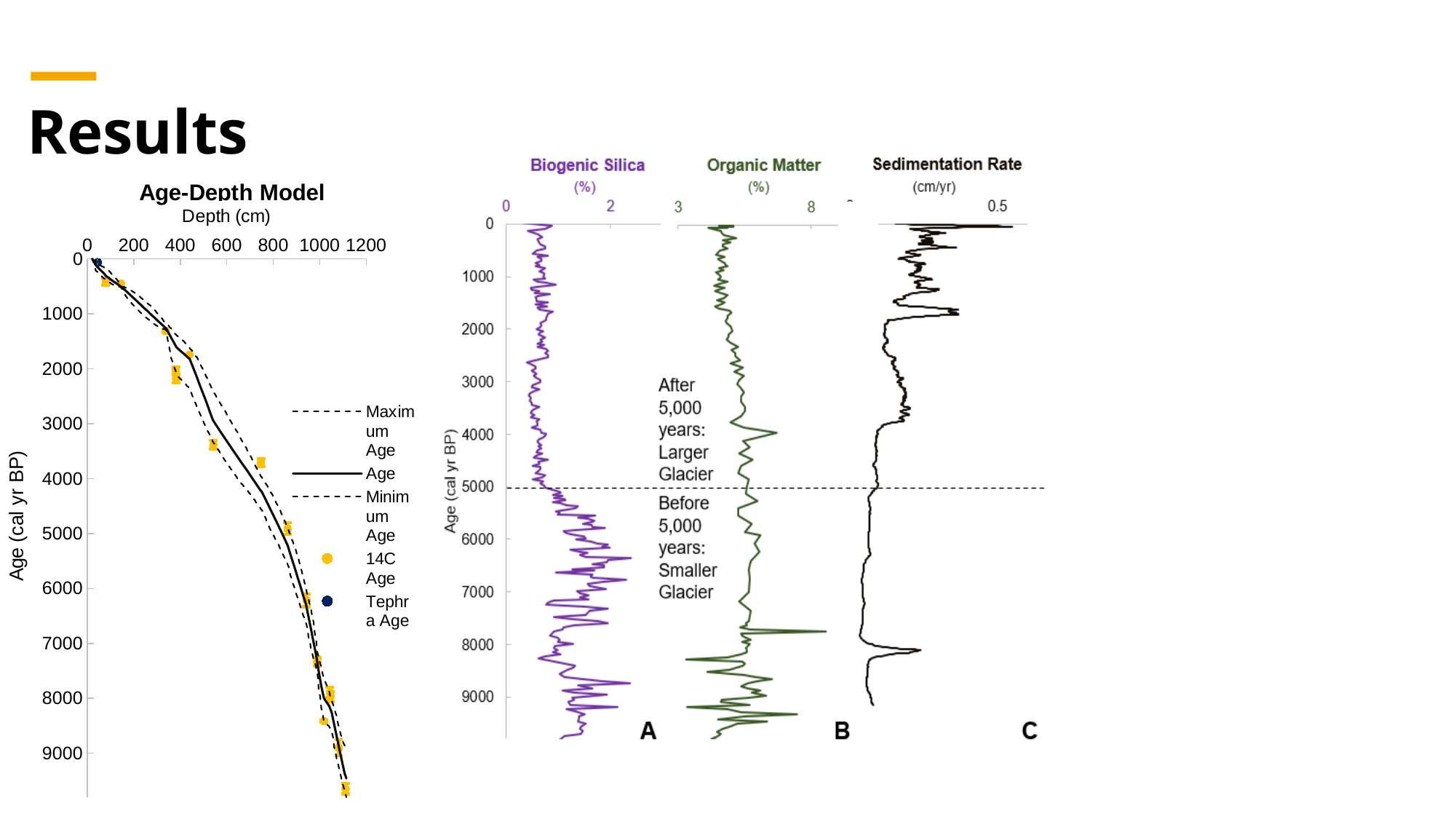
In the Age-Depth Model chart, what is the largest depth value shown on the horizontal axis? 1200 In the Organic Matter panel (panel B), what is the highest value labelled on the horizontal axis? 8 What is the title of the chart on the left of the slide? Age-Depth Model In the Age-Depth Model chart, what is the label of the horizontal axis? Depth (cm) What kind of chart is the Age-Depth Model? Line chart In the Biogenic Silica panel (panel A), is biogenic silica generally greater before 5,000 years (deeper) or after 5,000 years? Before 5,000 years At what age (cal yr BP) is the horizontal dashed line drawn across panels A, B and C? 5000 In the Biogenic Silica panel (panel A), is the value at about 3000 cal yr BP greater or less than 2%? less In the Age-Depth Model chart, does age increase or decrease as depth increases? Increases In the Age-Depth Model chart, what is the largest age value labelled on the vertical axis? 9000 What unit is shown for the Sedimentation Rate panel (panel C)? cm/yr How many entries does the legend of the Age-Depth Model chart list? 5